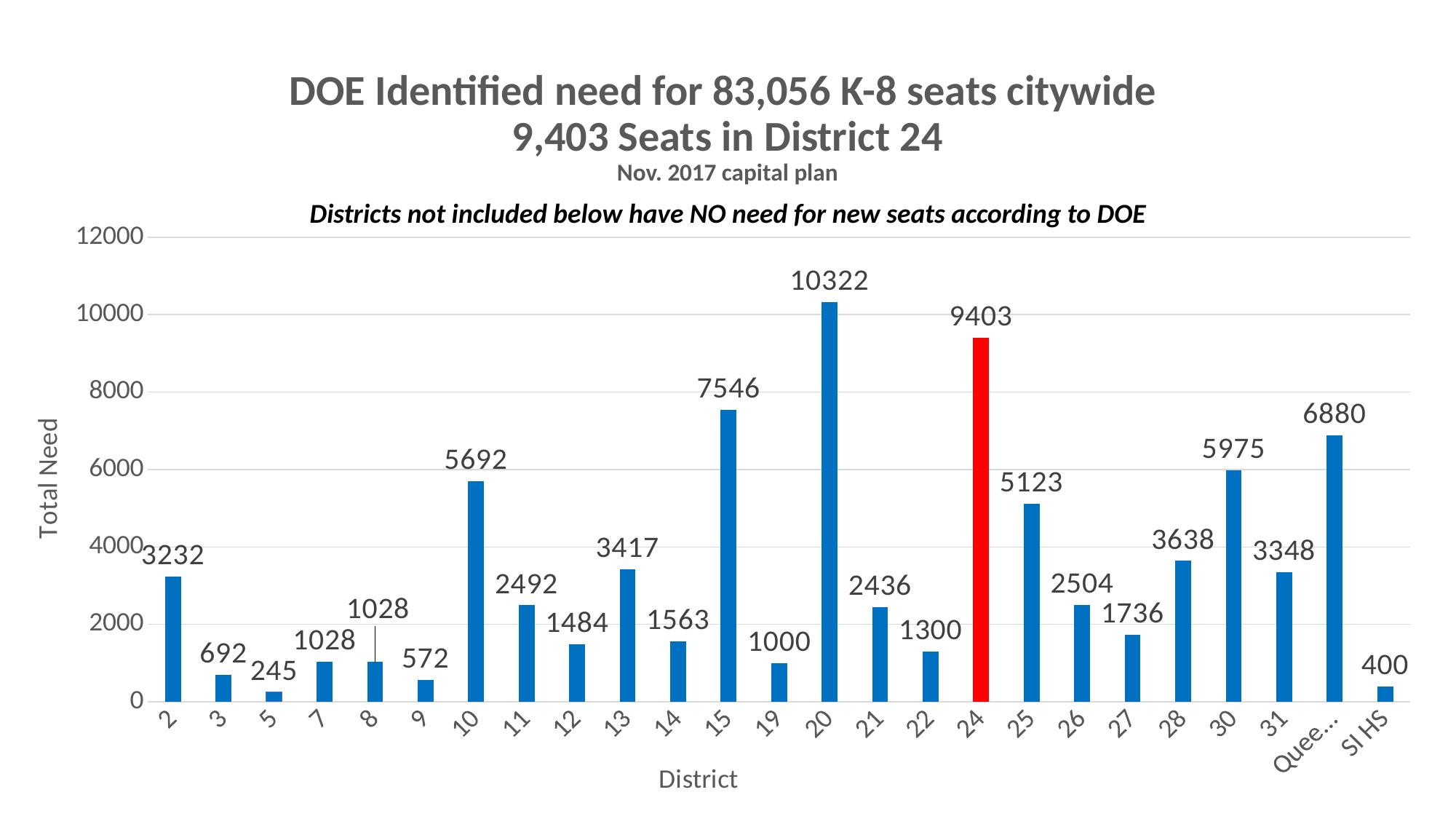
What is the total need for SI HS? 400 Which district has the highest total need? 20 What is the label of the y axis? Total Need What is the total need for District 15? 7546 Which has a larger total need, District 10 or District 30? District 30 Is the value for District 28 greater or less than 4000? less Which district's bar is coloured red? 24 What kind of chart is shown on the slide? Bar chart What is the difference in total need between District 20 and District 24? 919 How many districts are shown on the x axis? 25 Which district has the lowest total need? 5 What is the total need for District 24? 9403